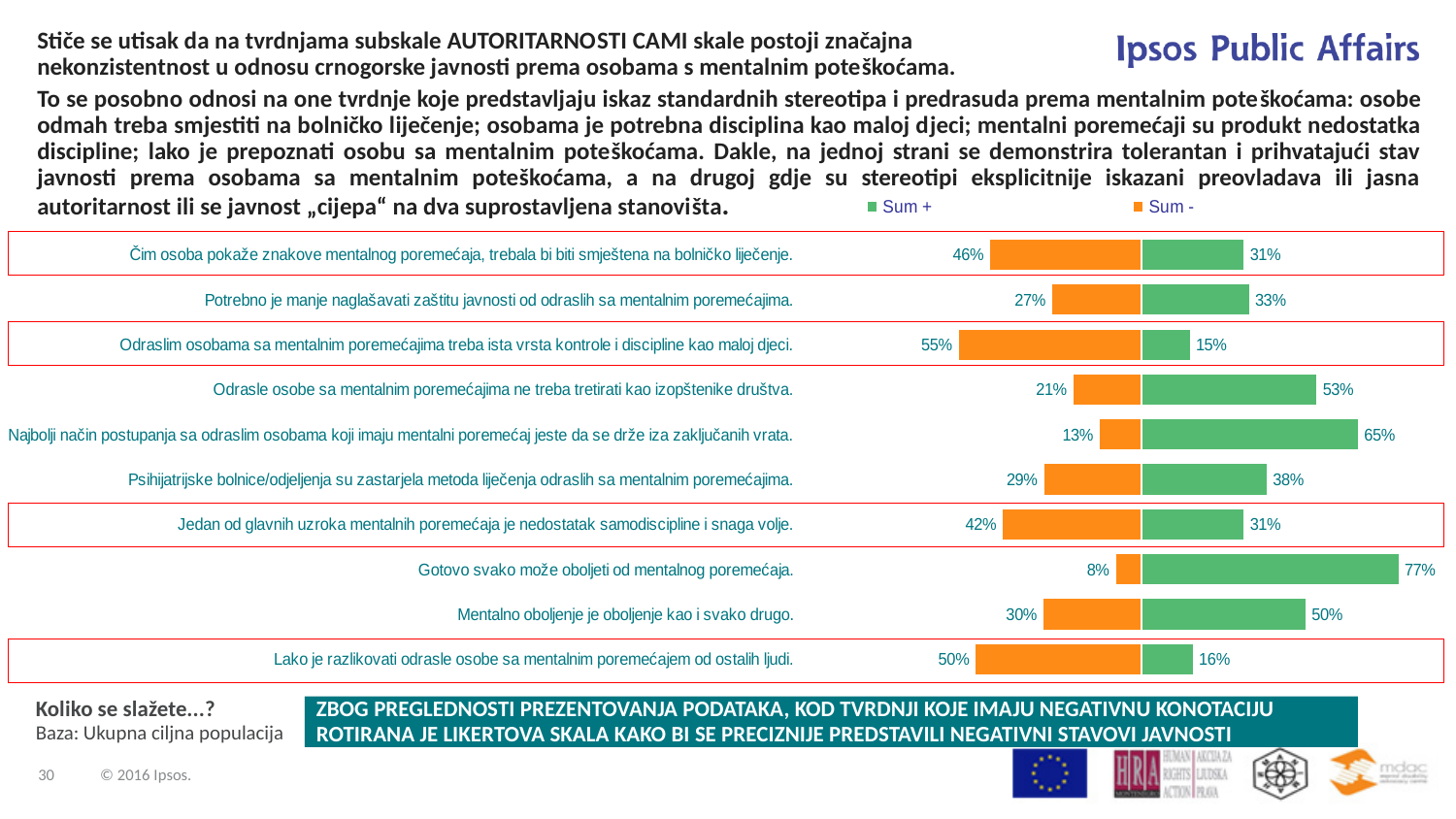
How many series does the chart legend list? 2 What is the value of the green bar for the statement "Gotovo svako može oboljeti od mentalnog poremećaja."? 77% For the statement "Čim osoba pokaže znakove mentalnog poremećaja, trebala bi biti smještena na bolničko liječenje.", what is the difference between the orange bar value and the green bar value? 15 percentage points What type of chart is shown on the slide? bar chart How many statements (categories) are plotted in the chart? 10 What are the two series names shown in the chart legend? Sum + and Sum - For the statement "Lako je razlikovati odrasle osobe sa mentalnim poremećajem od ostalih ljudi.", what is the sum of the orange and green bar values? 66% For the statement "Potrebno je manje naglašavati zaštitu javnosti od odraslih sa mentalnim poremećajima.", which bar is larger, the orange or the green? green Which statement has the highest green bar value? Gotovo svako može oboljeti od mentalnog poremećaja. What is the value of the orange bar for the statement "Odraslim osobama sa mentalnim poremećajima treba ista vrsta kontrole i discipline kao maloj djeci."? 55% What is the value of the green bar for the statement "Najbolji način postupanja sa odraslim osobama koji imaju mentalni poremećaj jeste da se drže iza zaključanih vrata."? 65% Which statement has the lowest orange bar value? Gotovo svako može oboljeti od mentalnog poremećaja.